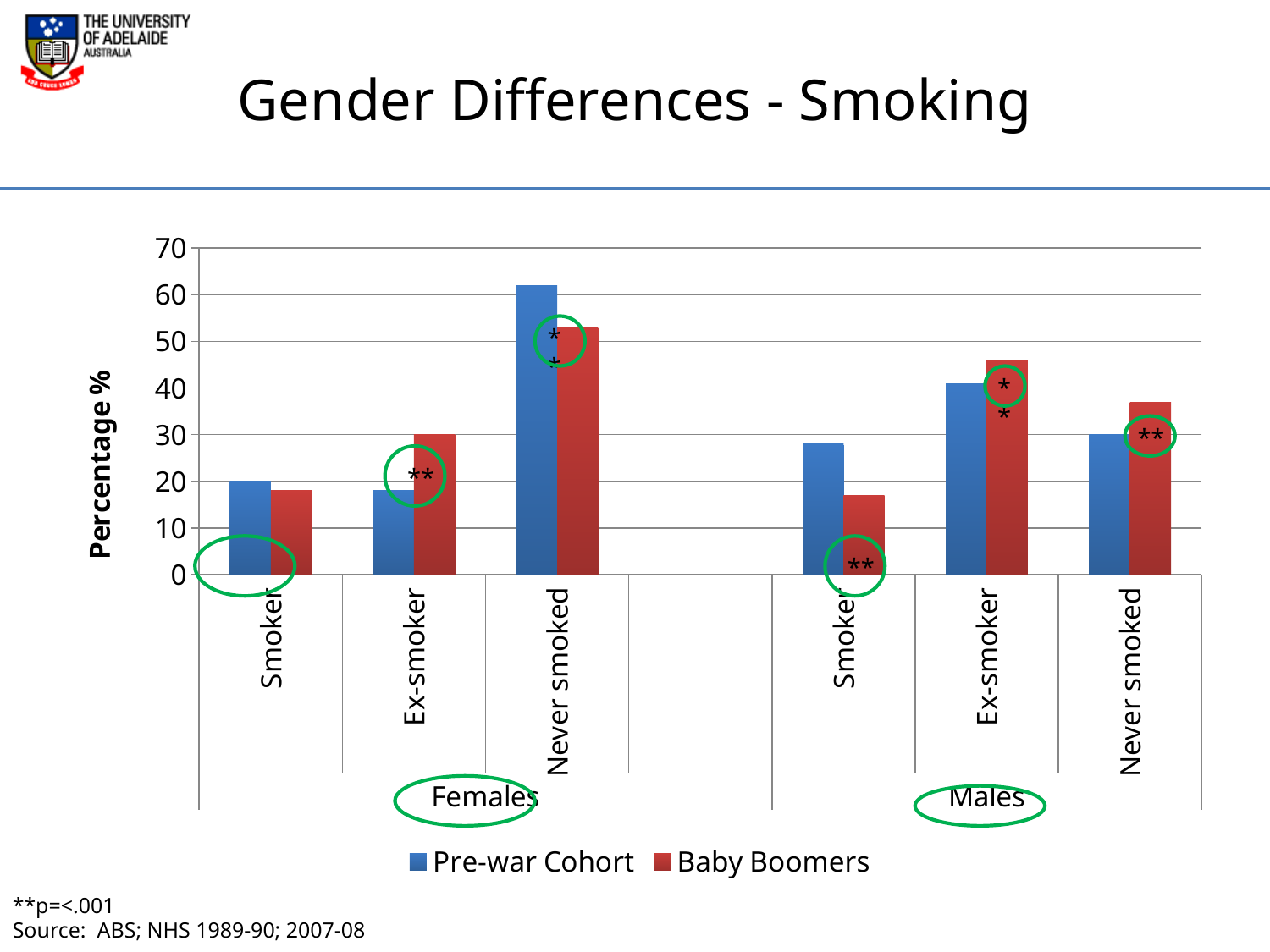
Is the Baby Boomers value for Males who are Ex-smokers greater or less than 40? greater For Males who are Ex-smokers, which series has the larger value, Pre-war Cohort or Baby Boomers? Baby Boomers What are the two series named in the legend? Pre-war Cohort and Baby Boomers How many smoking-status categories are plotted across both gender groups? 6 What is the Baby Boomers value for Females who are Ex-smokers? 30 What is the label on the vertical axis? Percentage % How many series does the legend list? 2 What is the Pre-war Cohort value for Females who are Smokers? 20 Is the Baby Boomers value for Males who are Smokers greater or less than 20? less Is the Pre-war Cohort value for Females who Never smoked greater or less than 60? greater What kind of chart is shown on the slide? Bar chart Which category has the highest Pre-war Cohort value? Females Never smoked